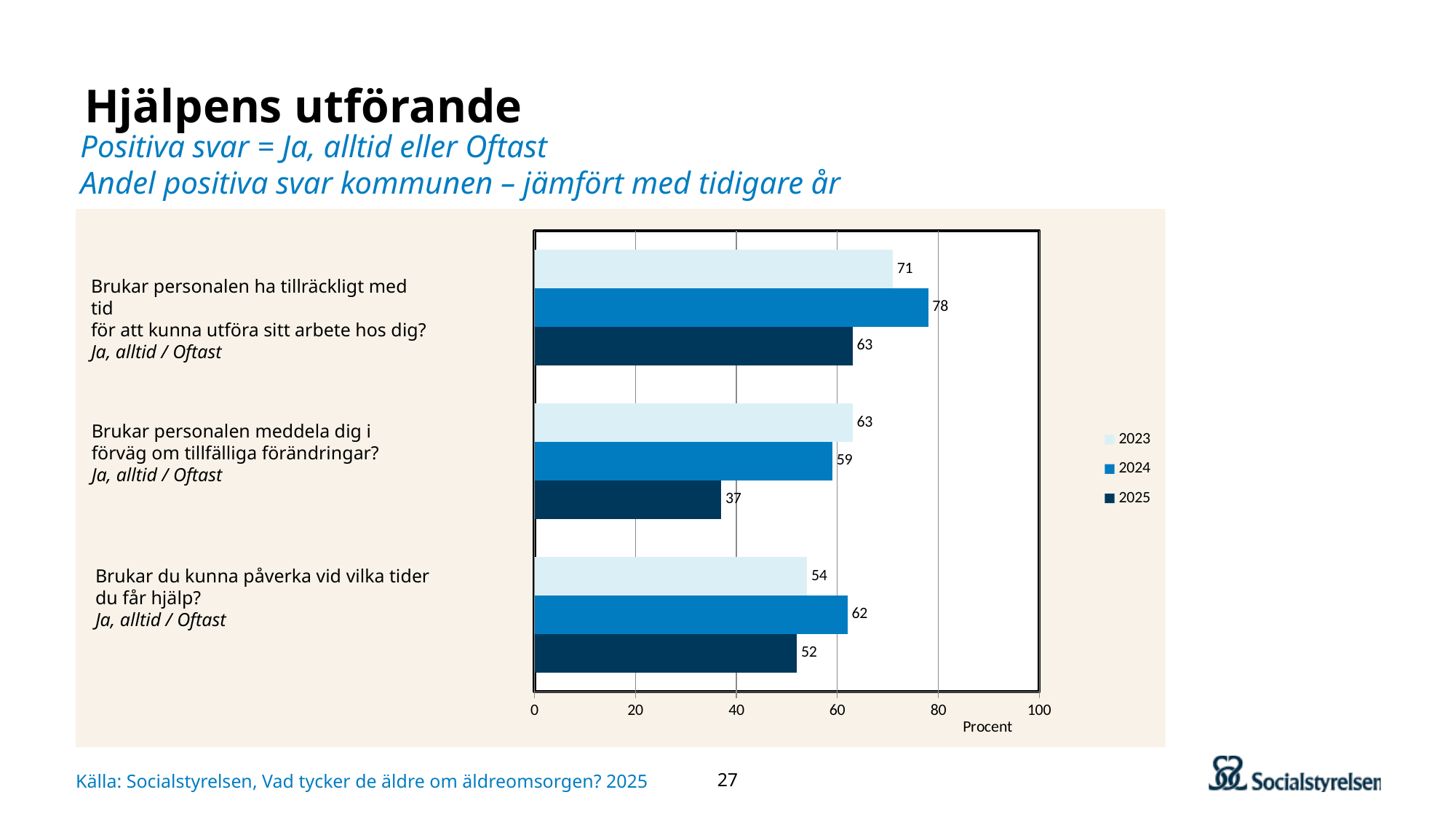
Which year has the lowest value for "Brukar personalen meddela dig i förväg om tillfälliga förändringar?" 2025 Which is larger: the 2023 value or the 2025 value for "Brukar du kunna påverka vid vilka tider du får hjälp?" 2023 How many question categories are plotted in the chart? 3 What unit label is shown on the x axis of the chart? Procent What is the 2025 value for "Brukar personalen meddela dig i förväg om tillfälliga förändringar?" 37 Is the 2025 value for "Brukar personalen meddela dig i förväg om tillfälliga förändringar?" greater or less than 40? less What is the 2023 value for "Brukar du kunna påverka vid vilka tider du får hjälp?" 54 Which year has the highest value for "Brukar du kunna påverka vid vilka tider du får hjälp?" 2024 What is the difference between the 2024 and 2025 values for "Brukar personalen ha tillräckligt med tid för att kunna utföra sitt arbete hos dig?" 15 How many series does the legend list? 3 What is the 2024 value for "Brukar personalen ha tillräckligt med tid för att kunna utföra sitt arbete hos dig?" 78 What kind of chart is shown on the slide? bar chart